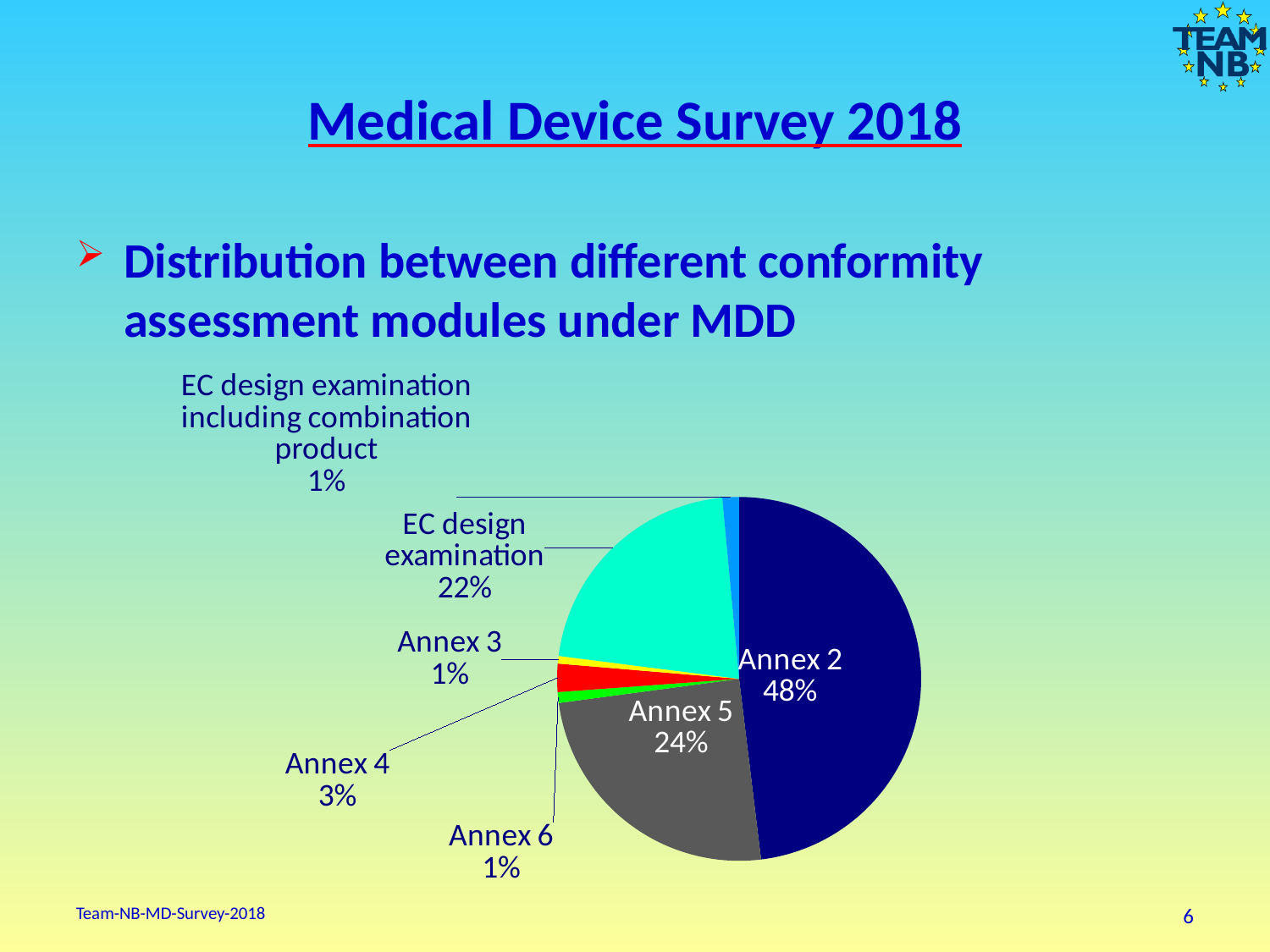
What percentage is shown for EC design examination? 22% What is the difference in percentage points between Annex 4 and Annex 3? 2 What is the difference in percentage points between Annex 2 and Annex 5? 24 What is the value shown for Annex 4? 3% Which is larger, the share for Annex 5 or the share for EC design examination? Annex 5 What percentage is shown for EC design examination including combination product? 1% How many slices does the pie chart have? 7 What is the value shown for Annex 5? 24% What kind of chart is shown on the slide? pie chart What share of the pie does Annex 2 represent? 48% What colour is the Annex 2 slice of the pie? dark blue Which slice of the pie is the largest? Annex 2